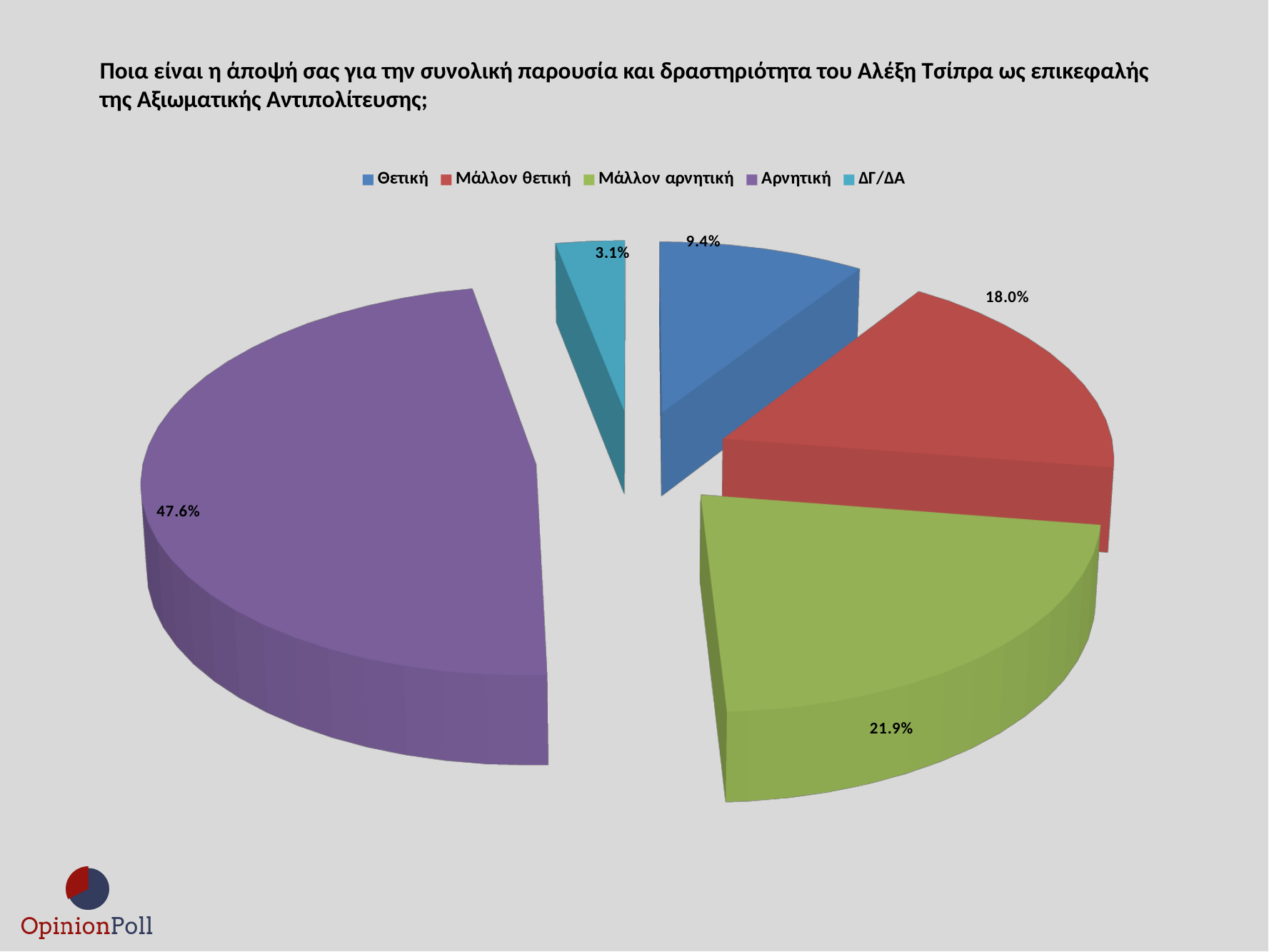
Which category has the smallest slice? ΔΓ/ΔΑ What is the value for Μάλλον θετική? 18.0% Which category has the largest slice? Αρνητική Which is larger, the value for Θετική or the value for Μάλλον θετική? Μάλλον θετική What is the value for ΔΓ/ΔΑ? 3.1% What kind of chart is shown on the slide? Pie chart What is the value for Θετική? 9.4% What is the difference between the values for Μάλλον αρνητική and Μάλλον θετική? 3.9% What is the value for Μάλλον αρνητική? 21.9% How many categories does the pie chart show? 5 What colour is the slice for Αρνητική? Purple What share of the pie does Αρνητική have? 47.6%